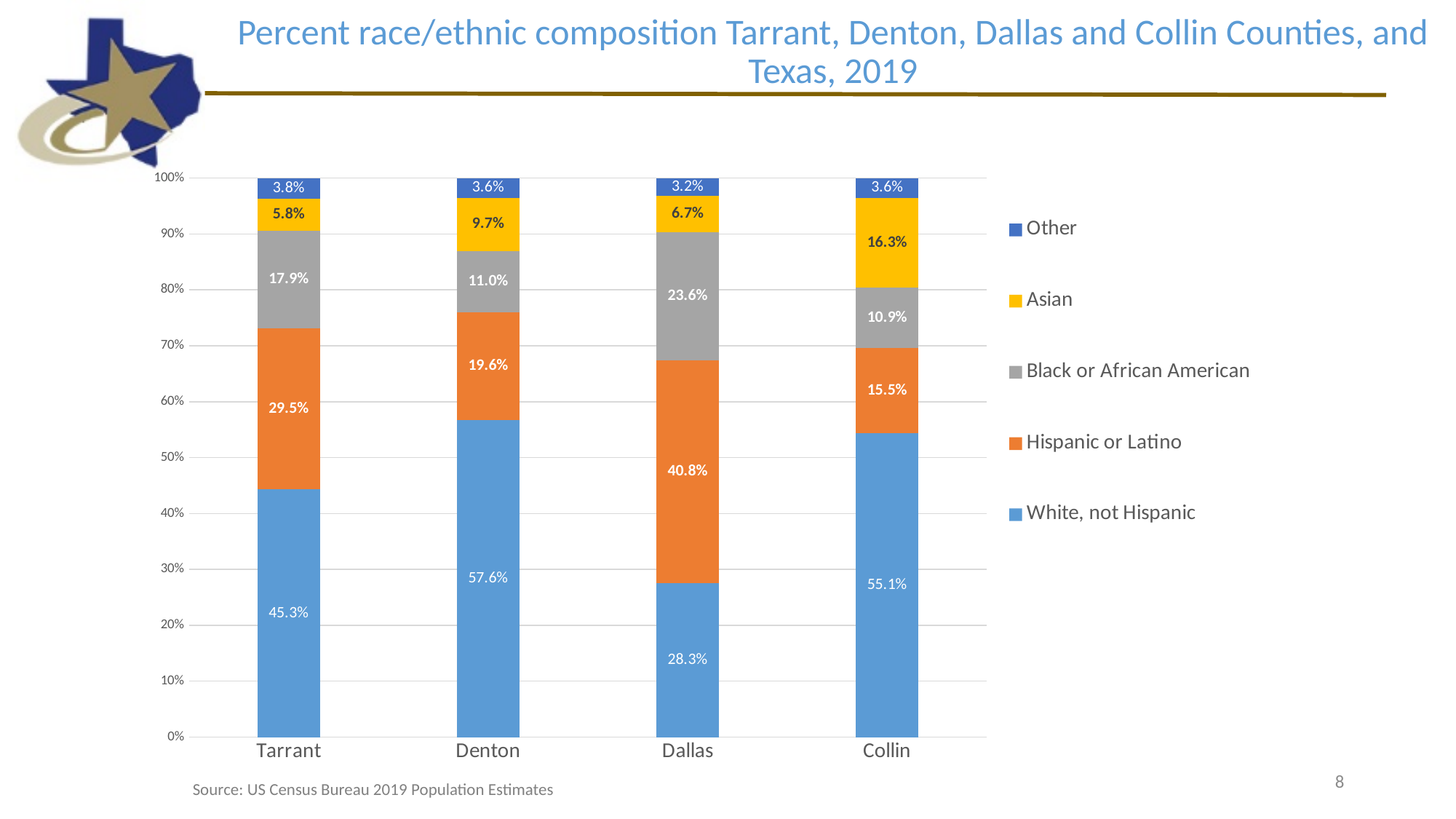
What is the difference between the Hispanic or Latino percentages for Dallas and Tarrant? 11.3% What is the Black or African American percentage for Tarrant? 17.9% What is the Hispanic or Latino percentage for Denton? 19.6% Which county has the lowest Other percentage? Dallas Which is larger, the Asian percentage for Denton or for Dallas? Denton How many series does the legend list? 5 Which county has the highest White, not Hispanic percentage? Denton Which legend entry is shown in orange? Hispanic or Latino What kind of chart is shown on the slide? Stacked bar chart What is the White, not Hispanic percentage for Dallas? 28.3% What is the Asian percentage for Collin? 16.3% How many counties are shown on the x axis of the chart? 4